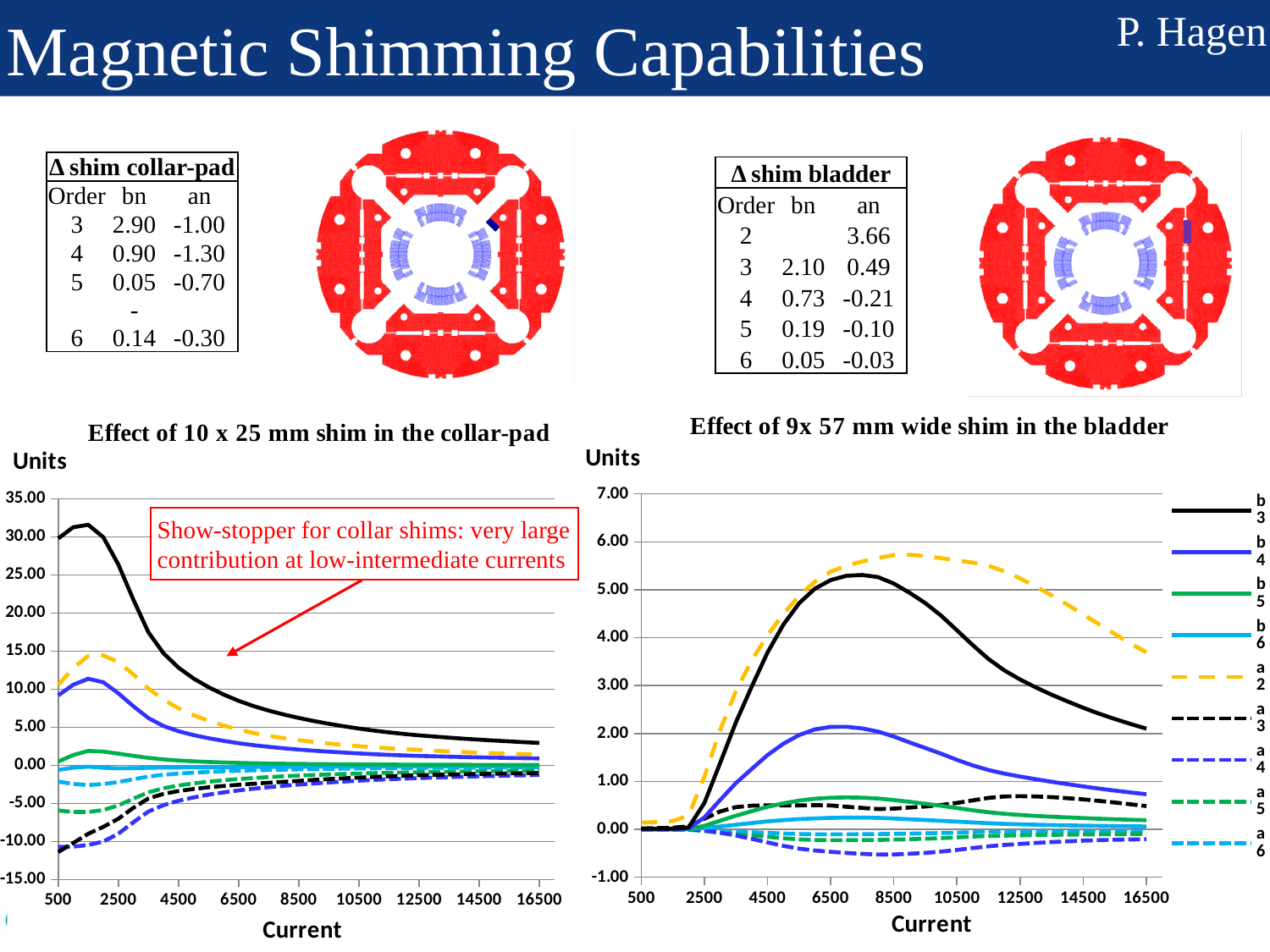
How many series does the legend of the chart titled 'Effect of 9x 57 mm wide shim in the bladder' list? 9 What is the x-axis label of the chart titled 'Effect of 10 x 25 mm shim in the collar-pad'? Current In the chart titled 'Effect of 9x 57 mm wide shim in the bladder', is the peak value of series a2 greater or less than 6.00? less In the chart titled 'Effect of 9x 57 mm wide shim in the bladder', does series b3 rise or fall between currents of 8500 and 16500? fall In the chart titled 'Effect of 9x 57 mm wide shim in the bladder', at a current of 16500, which is larger: the value of b3 or the value of a2? a2 In the chart titled 'Effect of 9x 57 mm wide shim in the bladder', which series has the highest value at a current of 16500? a2 In the chart titled 'Effect of 9x 57 mm wide shim in the bladder', is the lowest value of series a4 greater or less than 0.00? less In the chart titled 'Effect of 9x 57 mm wide shim in the bladder', which series has the lowest value at a current of 8500? a4 In the chart titled 'Effect of 10 x 25 mm shim in the collar-pad', is the peak value of the solid black line greater or less than 30.00? greater In the chart titled 'Effect of 10 x 25 mm shim in the collar-pad', does the solid black line rise or fall between currents of 2500 and 16500? fall What kind of chart is the chart titled 'Effect of 9x 57 mm wide shim in the bladder'? line chart